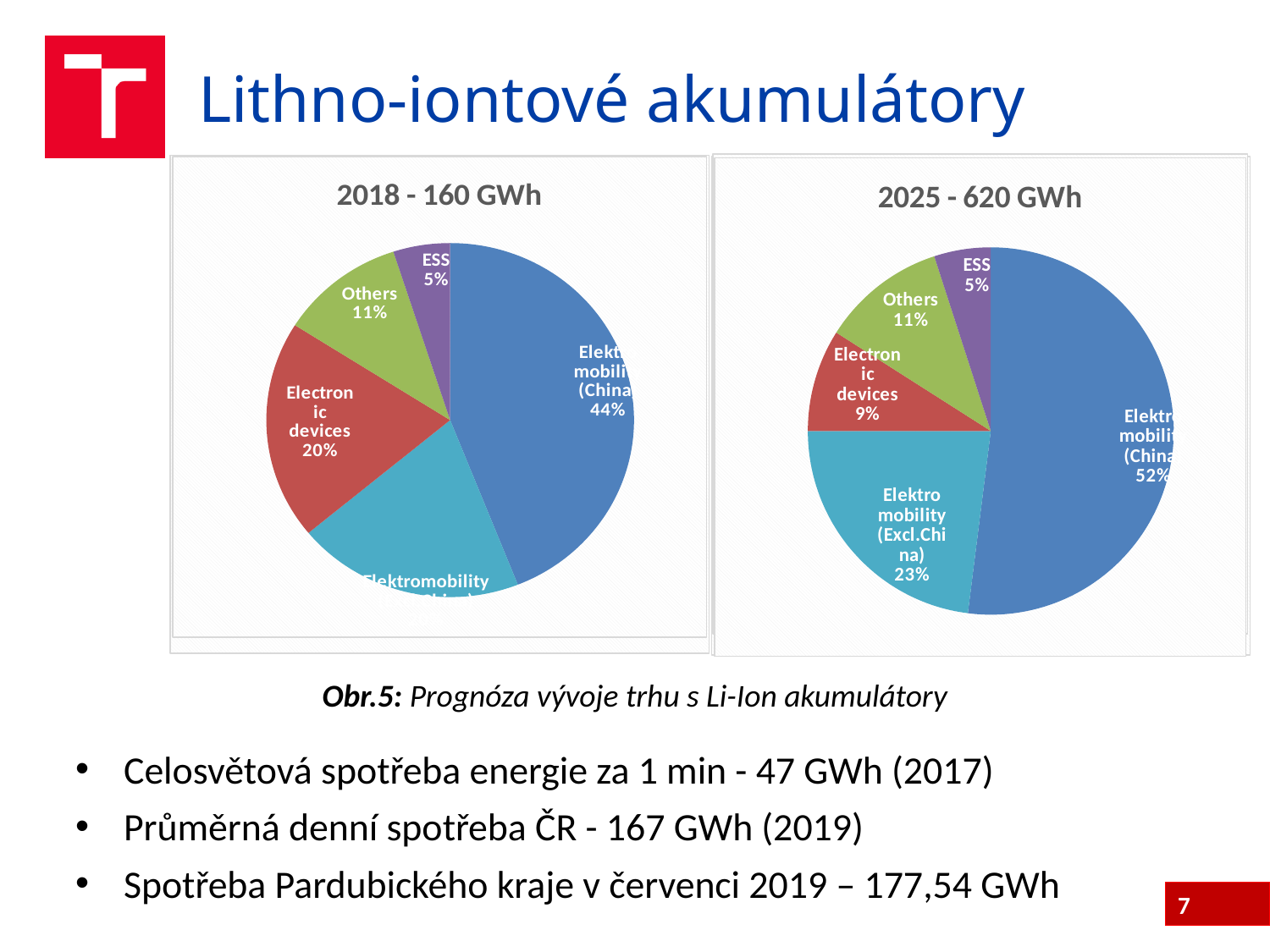
In the chart titled "2025 - 620 GWh", what share does Elektromobility (Excl.China) have? 23% In the chart titled "2025 - 620 GWh", what share does Elektromobility (China) have? 52% In the chart titled "2018 - 160 GWh", what share does Others have? 11% In the chart titled "2025 - 620 GWh", which category has the smallest slice? ESS In the chart titled "2025 - 620 GWh", which category has the largest slice? Elektromobility (China) In the chart titled "2025 - 620 GWh", which is larger, Others or ESS? Others How many categories are shown in the chart titled "2025 - 620 GWh"? 5 What kind of chart is used on the slide for the 2018 and 2025 data? Pie chart By how many percentage points is the Electronic devices share in the 2018 chart larger than in the 2025 chart? 11 percentage points